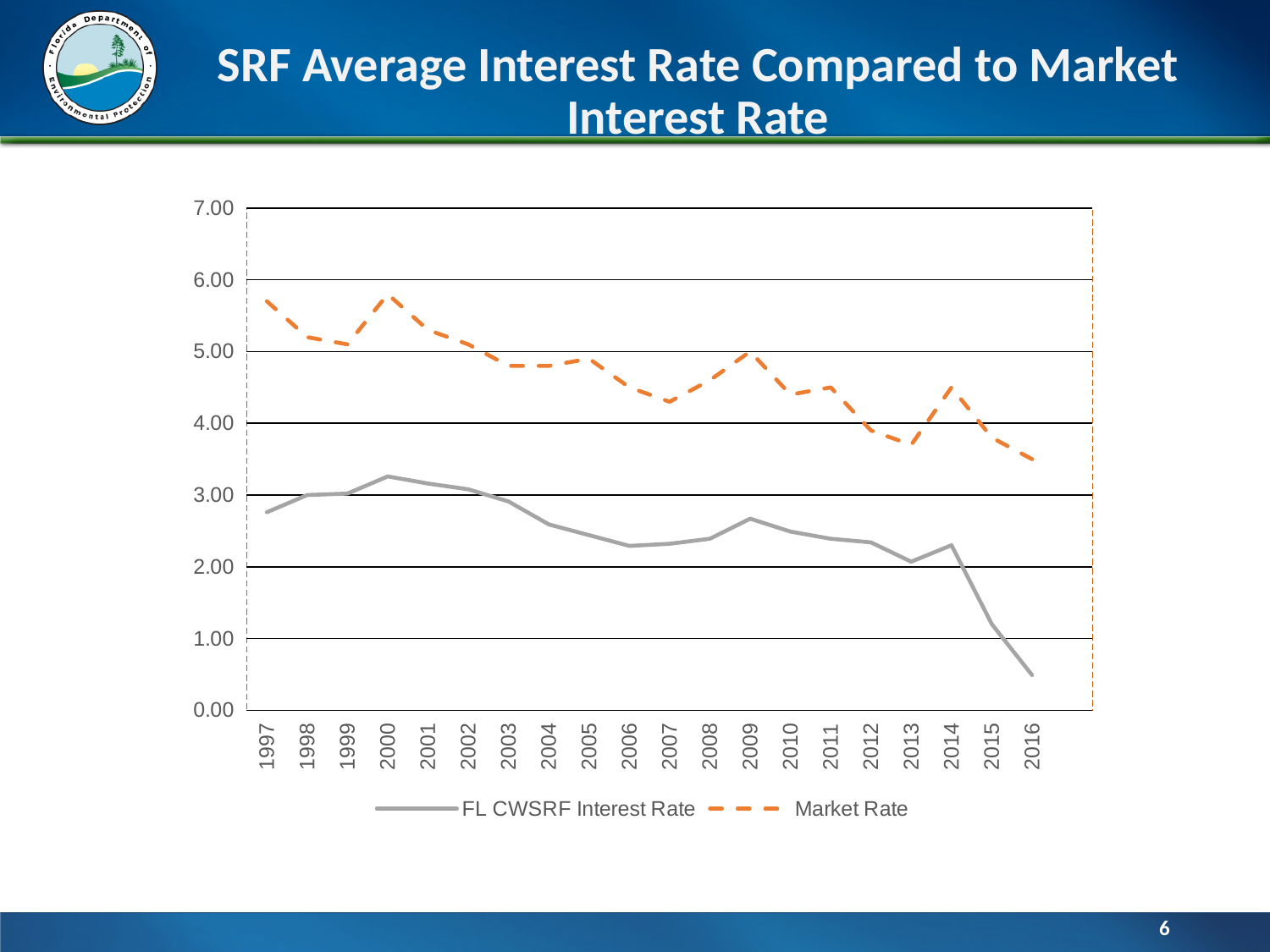
Which series is drawn with a dashed orange line? Market Rate In which year is the FL CWSRF Interest Rate lowest? 2016 Is the Market Rate for 1997 greater or less than 5.00? greater In 2010, which is higher, the Market Rate or the FL CWSRF Interest Rate? Market Rate How many series does the legend list? 2 Overall, does the FL CWSRF Interest Rate rise or fall from 1997 to 2016? fall Is the Market Rate for 2016 greater or less than 4.00? less Is the FL CWSRF Interest Rate for 2000 greater or less than 3.00? greater What kind of chart is shown on the slide? Line chart What is the title of the chart? SRF Average Interest Rate Compared to Market Interest Rate How many years are plotted along the x axis? 20